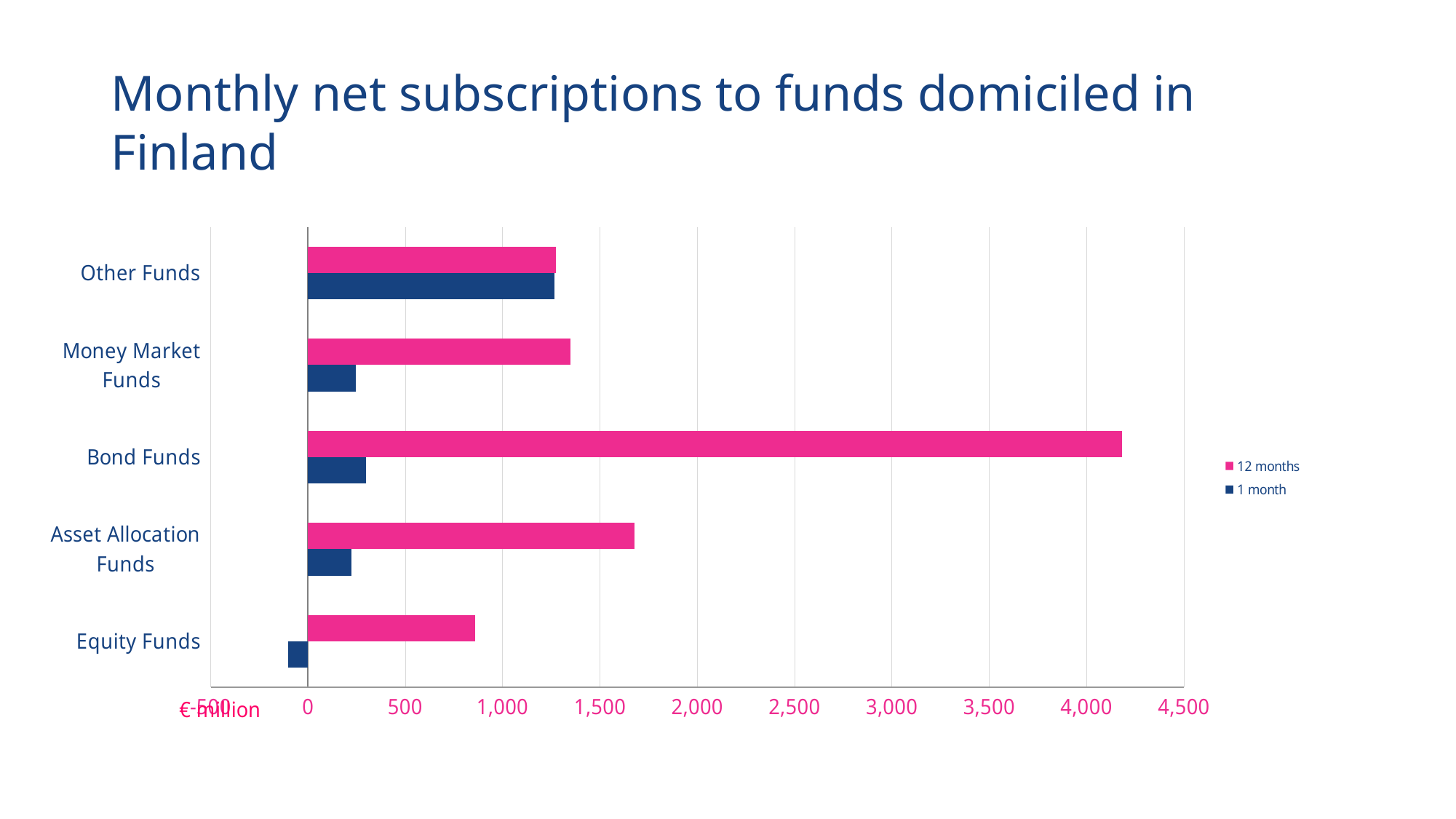
What kind of chart is shown on the slide? Bar chart Which fund category has the lowest 12 months value? Equity Funds How many fund categories are shown on the chart? 5 Is the 12 months value for Equity Funds greater or less than 1,000? less How many series does the legend list? 2 Is the 1 month value for Equity Funds greater or less than 0? less Which fund category has the lowest 1 month value? Equity Funds Which is larger for Money Market Funds: the 12 months value or the 1 month value? 12 months What unit is shown on the horizontal axis of the chart? € million Which fund category has the highest 12 months value? Bond Funds Which fund category has the highest 1 month value? Other Funds Is the 12 months value for Bond Funds greater or less than 4,000? greater